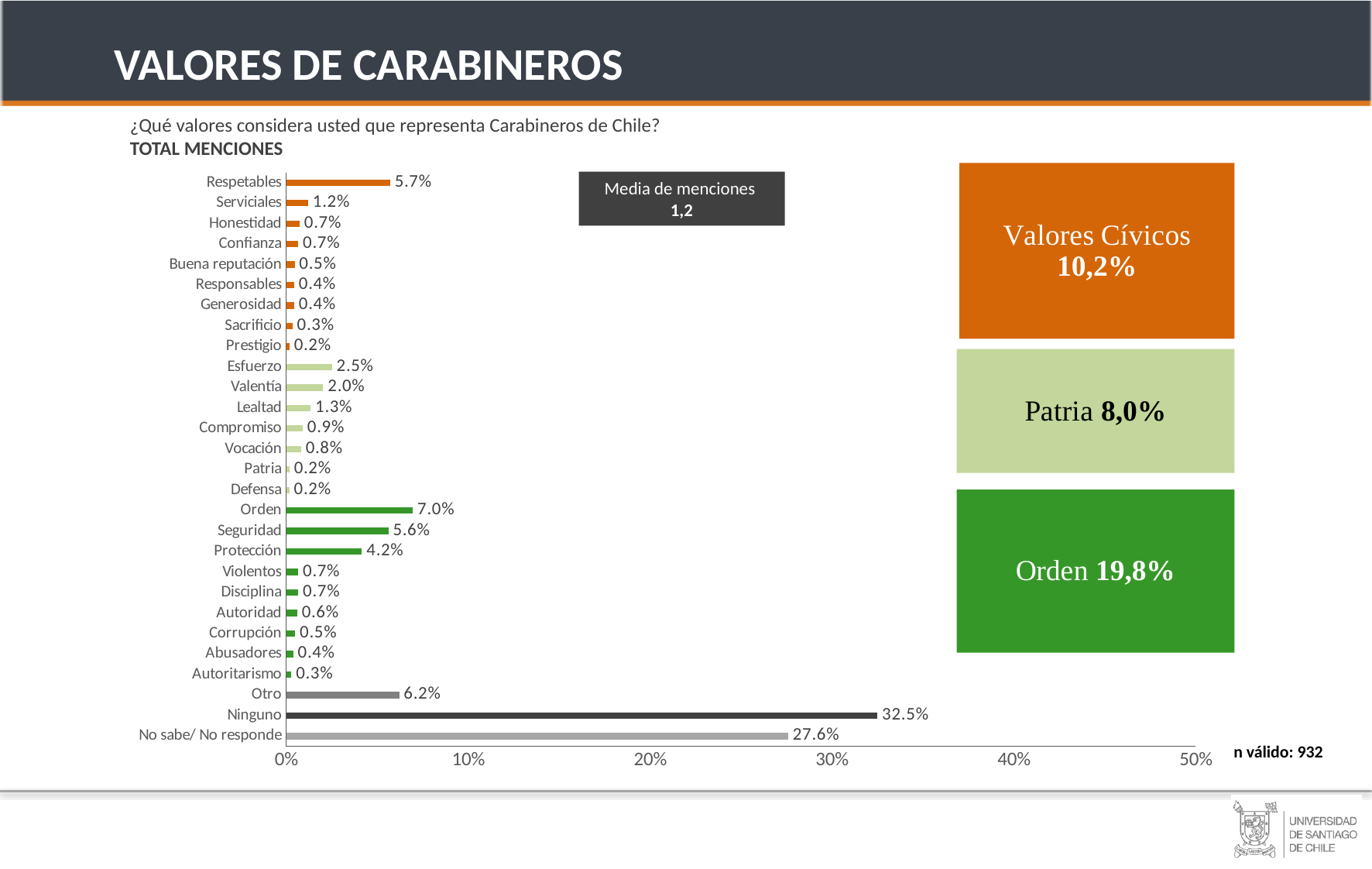
What is the value for Respetables? 5.7% How many categories are shown in the bar chart? 28 What is the value for Orden? 7.0% What is the value for Esfuerzo? 2.5% What is the difference between the values for Orden and Seguridad? 1.4% What is the difference between the values for Ninguno and No sabe/ No responde? 4.9% Which is larger, the value for Otro or the value for Respetables? Otro What is the value for No sabe/ No responde? 27.6% What kind of chart is shown on the slide? bar chart What is the 'Media de menciones' value shown on the slide? 1,2 Is the value for Ninguno greater or less than 30%? greater Which category has the highest value? Ninguno